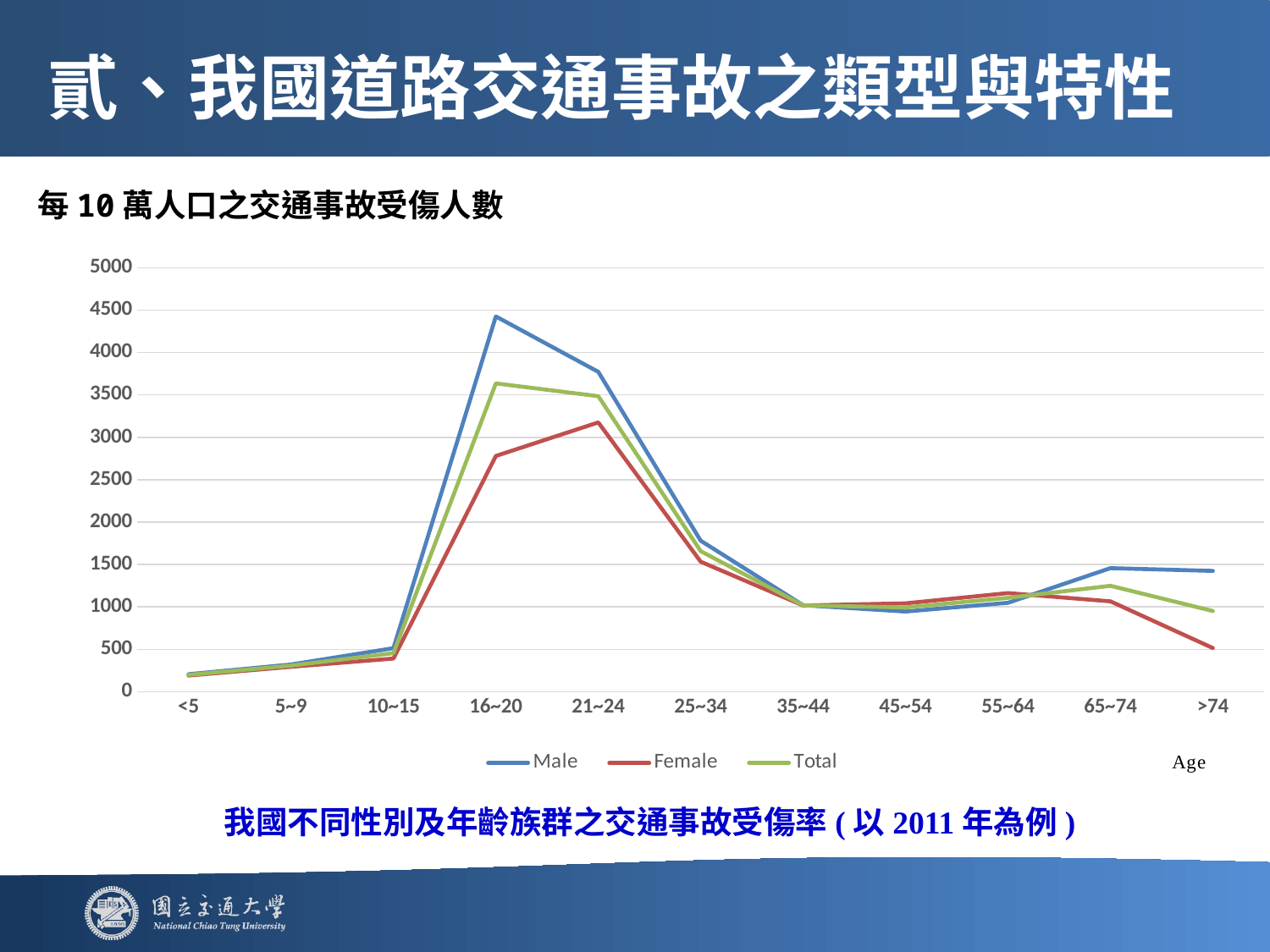
How many age groups are shown on the x axis? 11 Is the value for Female at age >74 greater or less than 1000? less What kind of chart is shown on the slide? line chart How many series does the legend list? 3 Which age group has the highest value for the Male series? 16~20 Which is larger at age 16~20, the Male value or the Female value? Male Which age group has the highest value for the Female series? 21~24 Does the Male series rise or fall from age 16~20 to age 35~44? fall Is the value for Male at age 16~20 greater or less than 4000? greater What label is shown at the right end of the x axis? Age Is the value for Female at age 16~20 greater or less than 2500? greater Which age group has the lowest value for the Total series? <5